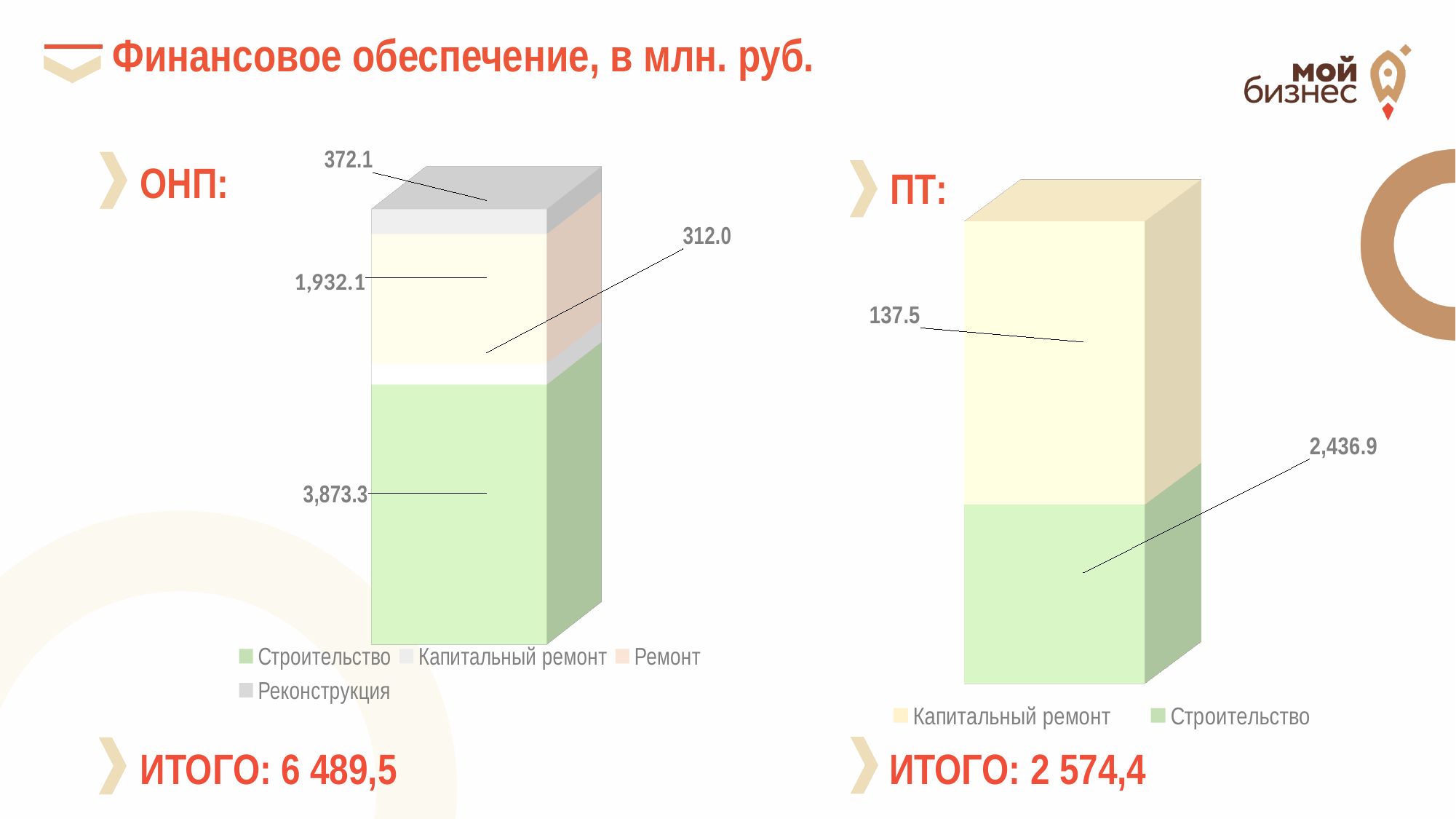
How many series does the legend of the ПТ chart list? 2 In the ОНП chart, what is the value for Ремонт? 1,932.1 In the ОНП chart, what is the value for Строительство? 3,873.3 In the ОНП chart, which segment has the lowest value? Капитальный ремонт In the ОНП chart, what is the value for Реконструкция? 372.1 In the ОНП chart, what is the difference between Строительство and Капитальный ремонт? 3,561.3 What is the total (ИТОГО) shown for the ПТ chart? 2 574,4 In the ОНП chart, which segment has the highest value? Строительство In the ОНП chart, what is the value for Капитальный ремонт? 312.0 What kind of chart is the ОНП chart? Stacked bar chart In the ОНП chart, which is larger: Реконструкция or Ремонт? Ремонт How many series does the legend of the ОНП chart list? 4